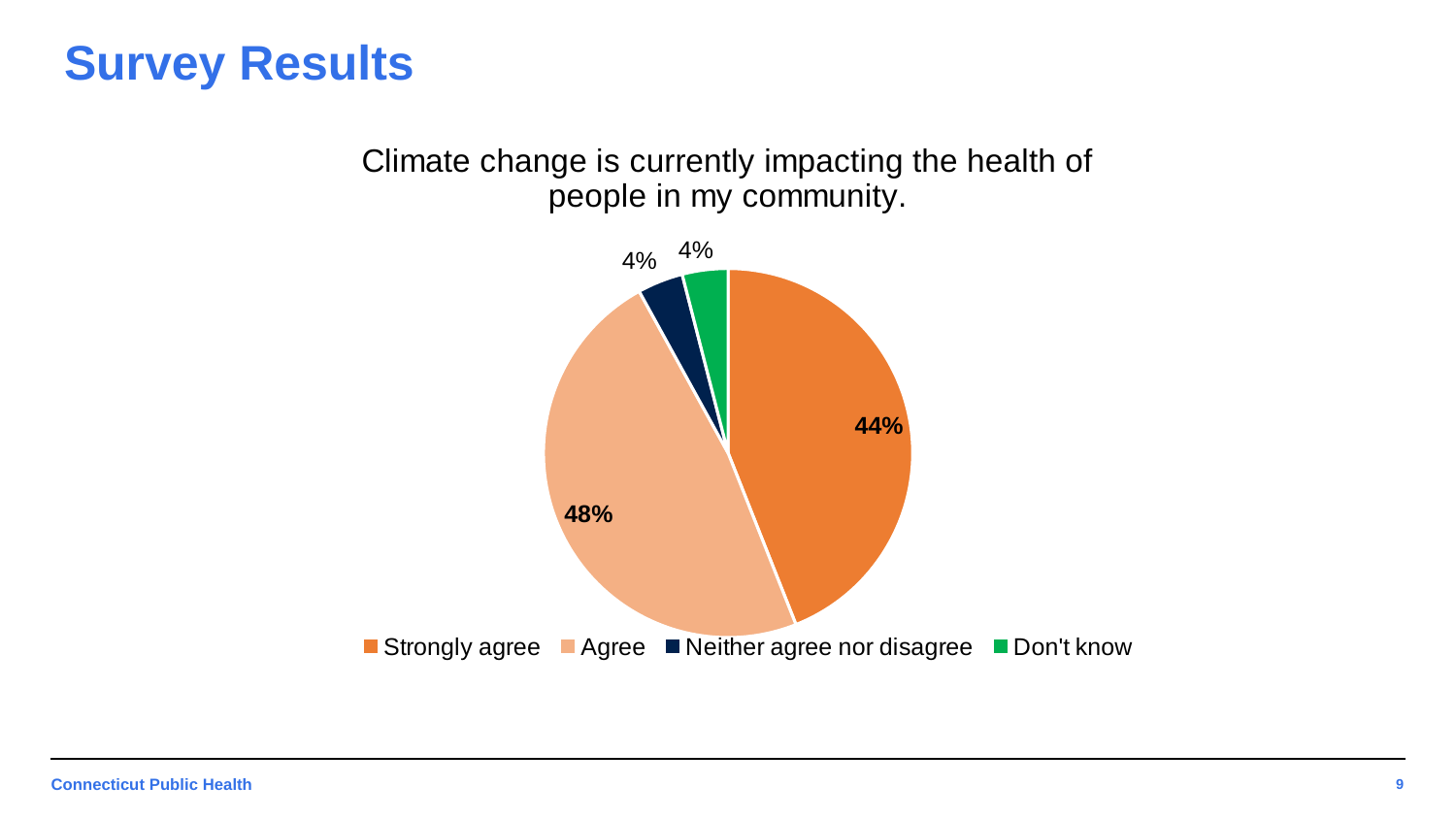
What is the difference in percentage points between "Agree" and "Strongly agree"? 4 How many response categories are shown in the pie chart? 4 What kind of chart is shown on the slide? Pie chart What percentage of respondents chose "Agree"? 48% What is the combined share of "Strongly agree" and "Agree"? 92% What percentage of respondents chose "Strongly agree"? 44% What is the title of the chart? Climate change is currently impacting the health of people in my community. What percentage of respondents chose "Neither agree nor disagree"? 4% Which is larger, the share for "Agree" or the share for "Strongly agree"? Agree Which response category has the largest share of the pie? Agree Which colour represents "Don't know" in the legend? Green What percentage of respondents chose "Don't know"? 4%